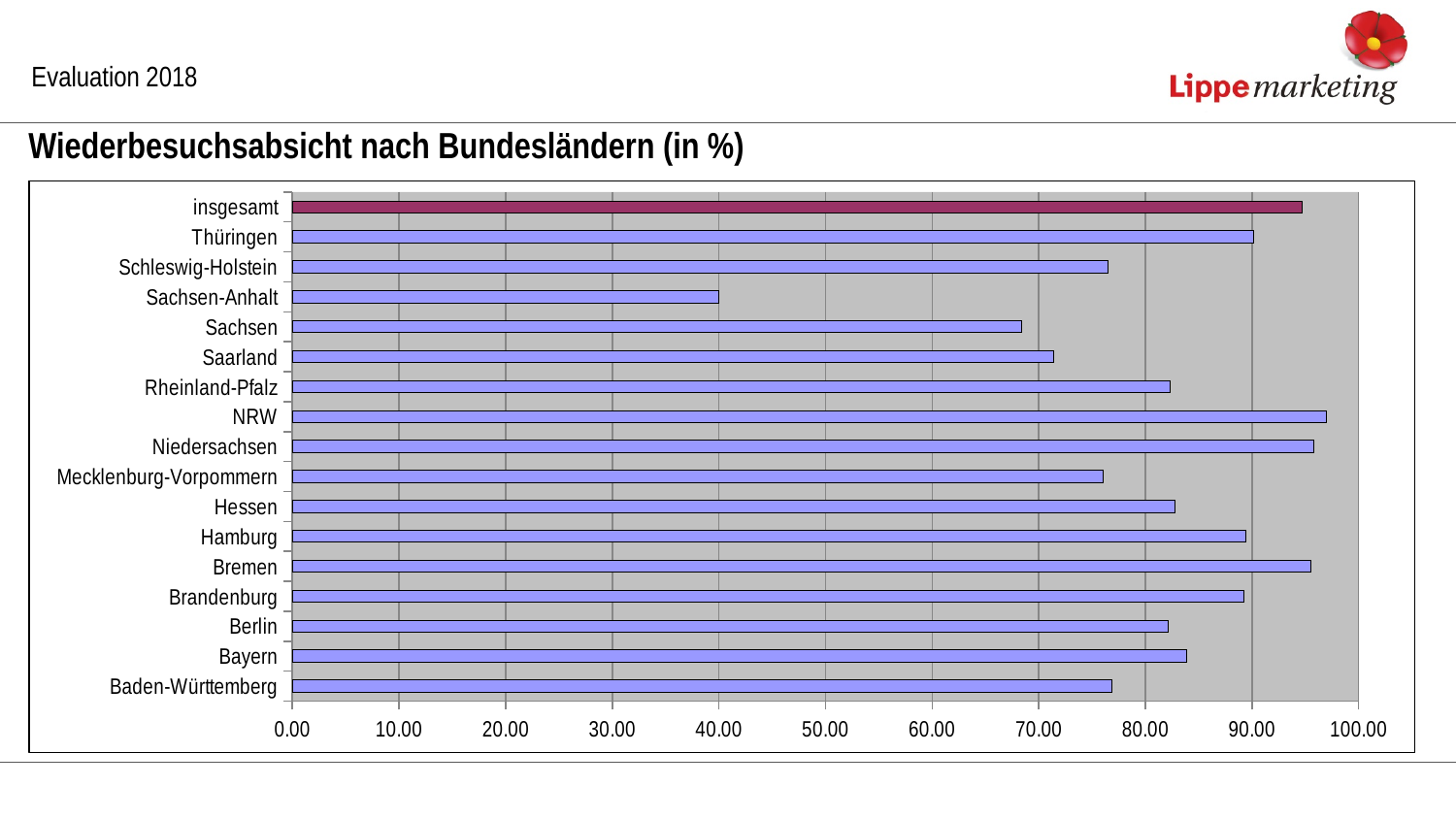
Is the value for Sachsen greater or less than 70.00? less How many categories (bars) are shown in the chart? 17 Which category has the highest value? NRW Which category has the lowest value? Sachsen-Anhalt Is the value for Schleswig-Holstein greater or less than 80.00? less Is the value for Sachsen-Anhalt greater or less than 50.00? less Which bar is drawn in a different colour from the others? insgesamt Which has the larger value, Sachsen or Saarland? Saarland What is the title of the chart? Wiederbesuchsabsicht nach Bundesländern (in %) What kind of chart is shown on the slide? bar chart